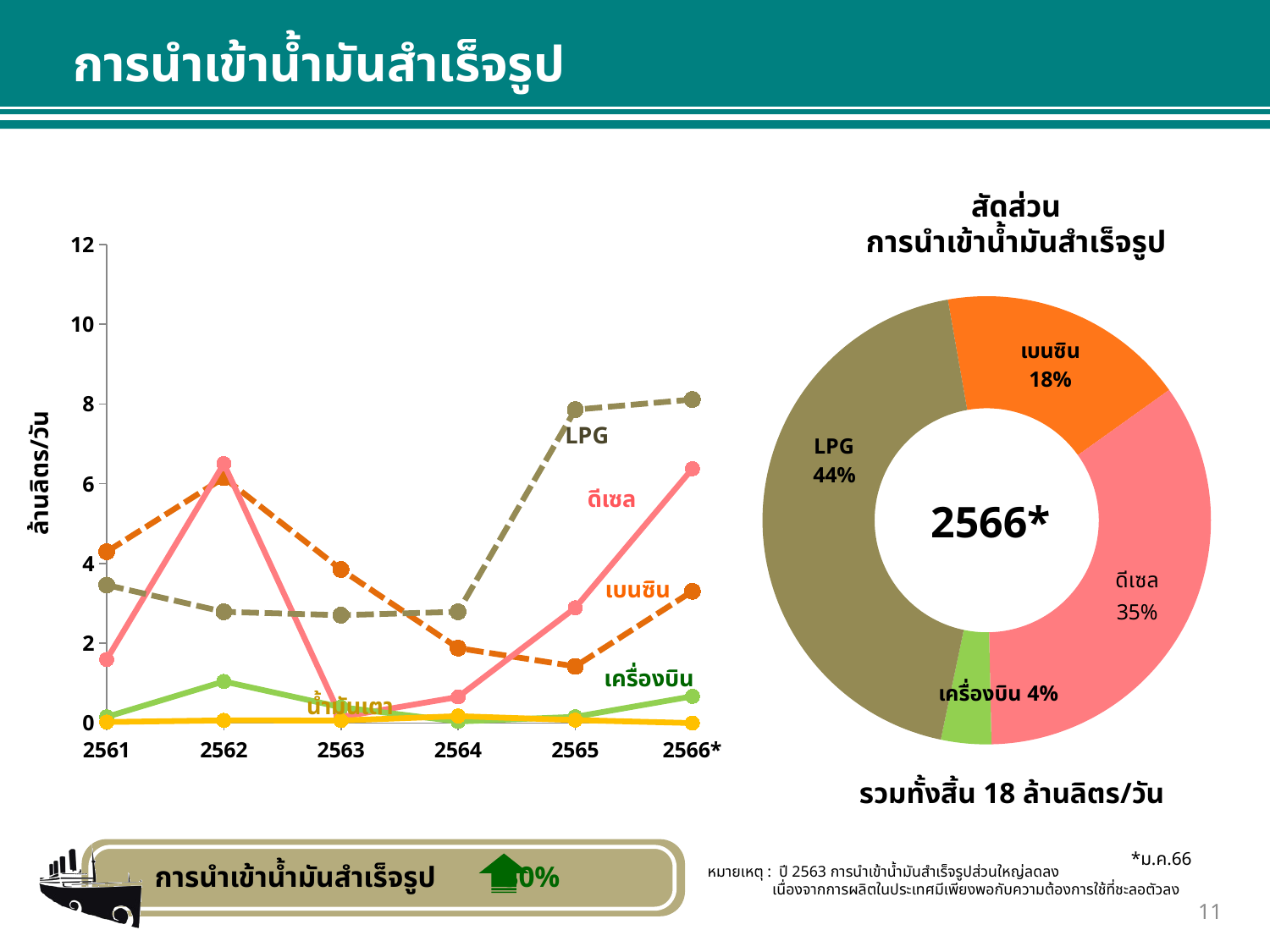
In the line chart on the left, does the LPG line rise or fall from 2564 to 2566*? rise In the line chart on the left, is the value for LPG in 2564 greater or less than 4? less In the line chart on the left, is the value for ดีเซล in 2563 greater or less than 2? less In the line chart on the left, how many years are shown on the x axis? 6 In the line chart on the left, how many series (lines) are plotted? 5 In the chart titled สัดส่วนการนำเข้าน้ำมันสำเร็จรูป, which category has the smallest share? เครื่องบิน In the chart titled สัดส่วนการนำเข้าน้ำมันสำเร็จรูป, what share does LPG have? 44% In the chart titled สัดส่วนการนำเข้าน้ำมันสำเร็จรูป, which is larger, เบนซิน or ดีเซล? ดีเซล What kind of chart is the chart on the left of the slide? line chart In the line chart on the left, does the ดีเซล line rise or fall from 2562 to 2563? fall In the line chart on the left, is the value for LPG in 2566* greater or less than 6? greater In the chart titled สัดส่วนการนำเข้าน้ำมันสำเร็จรูป, what is the difference in percentage points between LPG and ดีเซล? 9